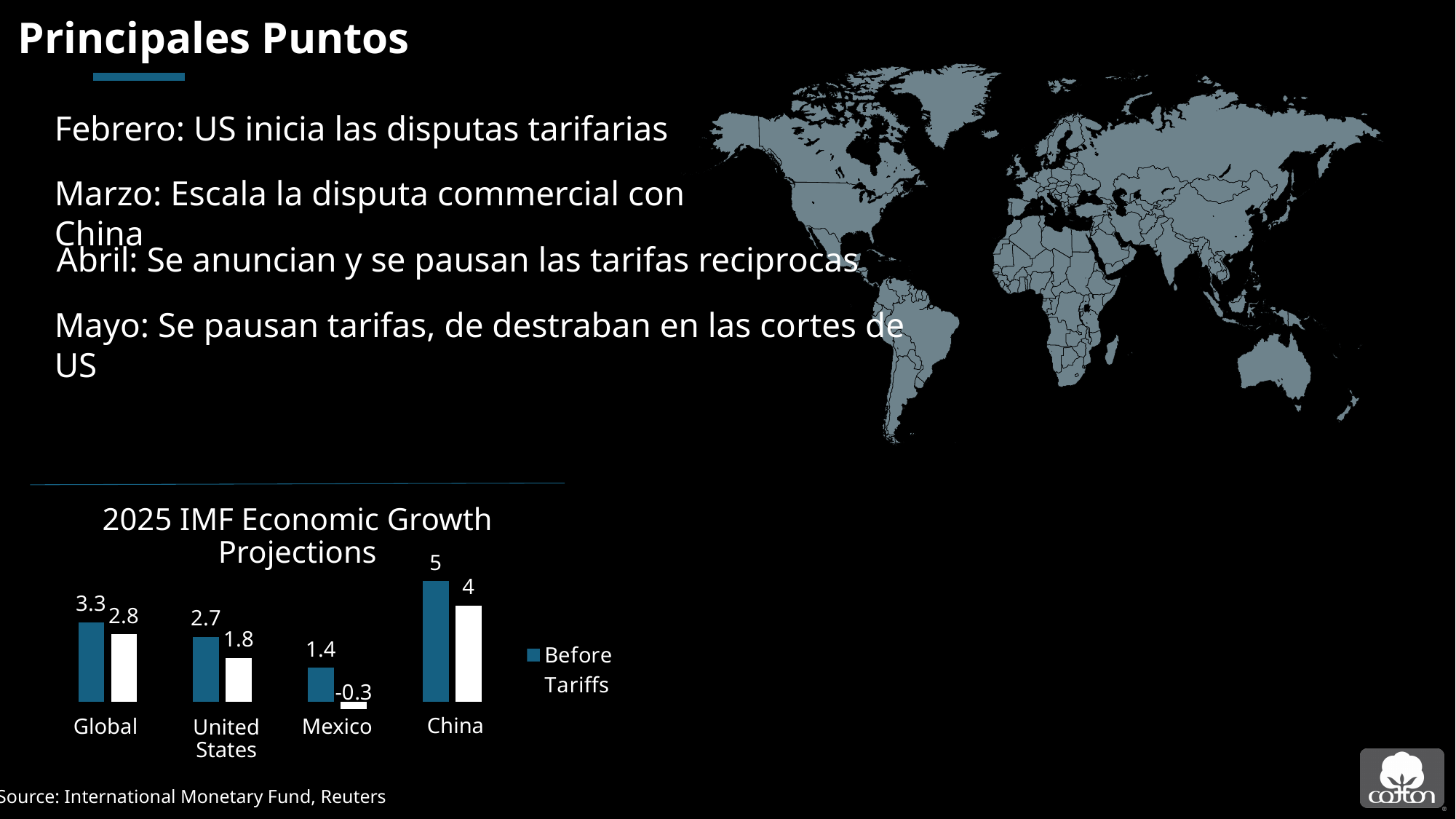
In the 2025 IMF Economic Growth Projections chart, what is the difference between the Before Tariffs value and the white bar value for China? 1 What is the title of the chart at the bottom left of the slide? 2025 IMF Economic Growth Projections In the 2025 IMF Economic Growth Projections chart, what is the difference between the Before Tariffs value and the white bar value for Global? 0.5 In the 2025 IMF Economic Growth Projections chart, what value is shown on the white bar for Global? 2.8 In the 2025 IMF Economic Growth Projections chart, which category has the lowest Before Tariffs value? Mexico In the 2025 IMF Economic Growth Projections chart, which category has the highest Before Tariffs value? China In the 2025 IMF Economic Growth Projections chart, which has the larger Before Tariffs value, Global or United States? Global In the 2025 IMF Economic Growth Projections chart, what is the Before Tariffs value for China? 5 In the 2025 IMF Economic Growth Projections chart, what is the Before Tariffs value for Mexico? 1.4 How many categories are shown on the x axis of the 2025 IMF Economic Growth Projections chart? 4 In the 2025 IMF Economic Growth Projections chart, what value is shown on the white bar for Mexico? -0.3 What kind of chart is the 2025 IMF Economic Growth Projections chart? Bar chart